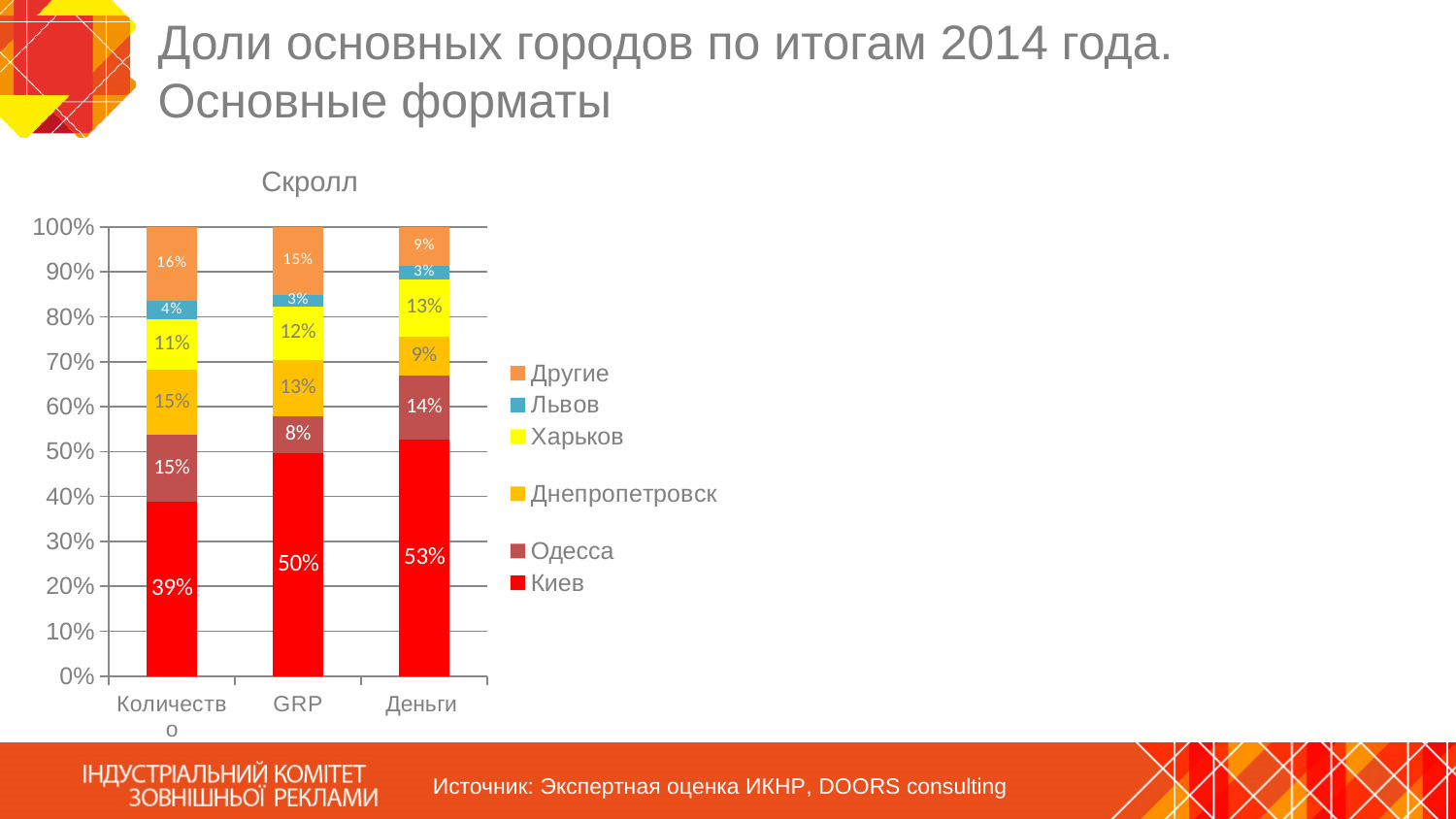
What is the difference between the Киев share in Деньги and in Количество? 14% What kind of chart is shown on the slide? Stacked bar chart In which category does Киев have the highest share? Деньги What is the share of Киев in the Количество bar? 39% Which is larger: the Харьков share in GRP or the Харьков share in Деньги? Деньги What is the share of Другие in the Деньги bar? 9% In which category does Одесса have the lowest share? GRP How many series does the legend list? 6 What is the share of Киев in the GRP bar? 50% What is the share of Одесса in the Деньги bar? 14% How many categories are shown on the x axis? 3 What is the share of Львов in the Количество bar? 4%